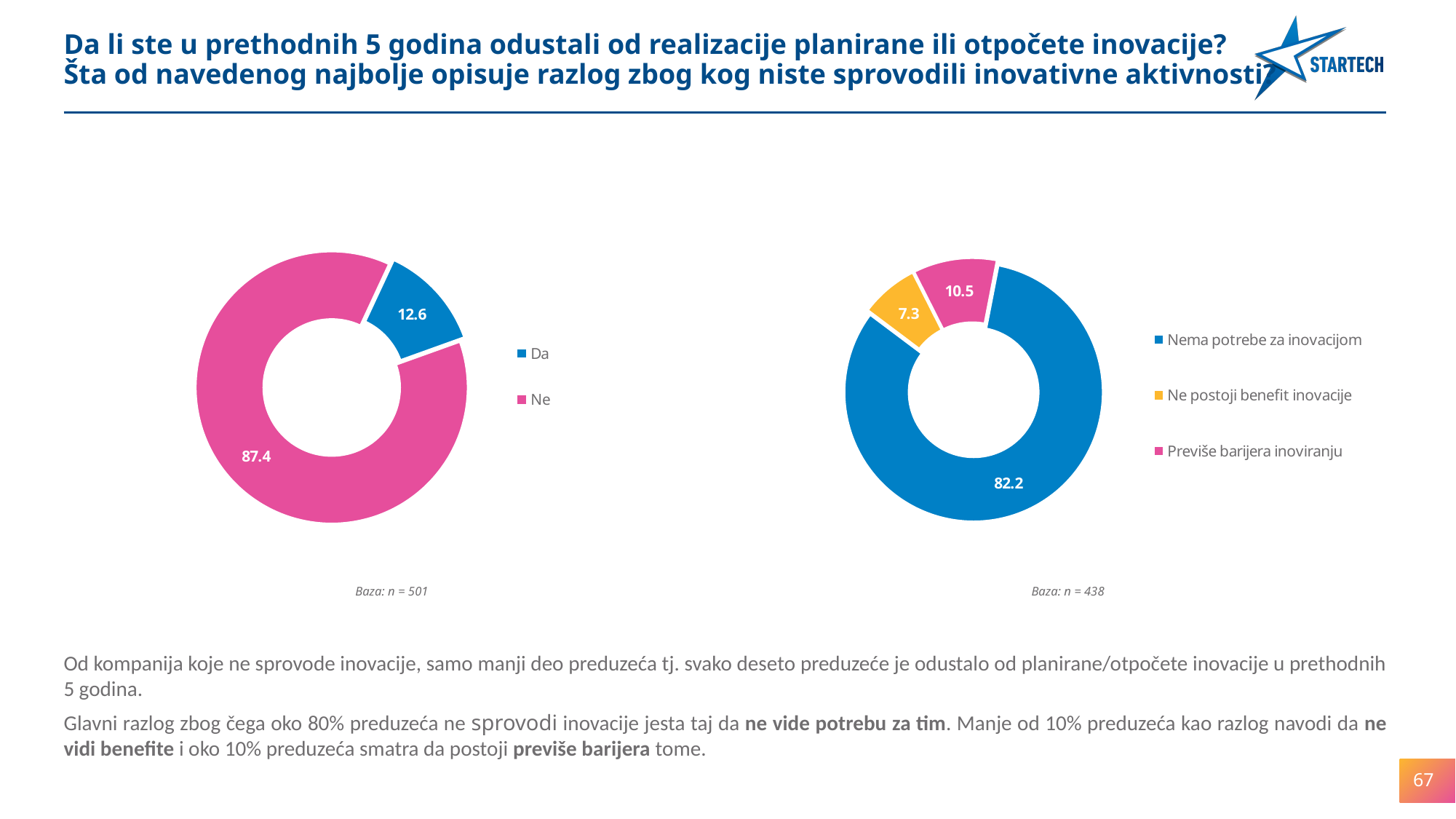
In the right chart, what is the value for "Previše barijera inoviranju"? 10.5 In the right chart, which is larger: "Previše barijera inoviranju" or "Ne postoji benefit inovacije"? Previše barijera inoviranju In the left chart, which category has the largest share? Ne What kind of chart is the right chart? Doughnut (pie) chart In the right chart, what is the value for "Nema potrebe za inovacijom"? 82.2 In the left chart, what is the difference between the values for "Ne" and "Da"? 74.8 In the left chart, how many categories does the legend list? 2 In the left chart, what is the value for "Ne"? 87.4 In the right chart, what is the difference between "Previše barijera inoviranju" and "Ne postoji benefit inovacije"? 3.2 In the right chart, which category has the smallest share? Ne postoji benefit inovacije In the left chart, what is the value for "Da"? 12.6 In the right chart, what is the value for "Ne postoji benefit inovacije"? 7.3